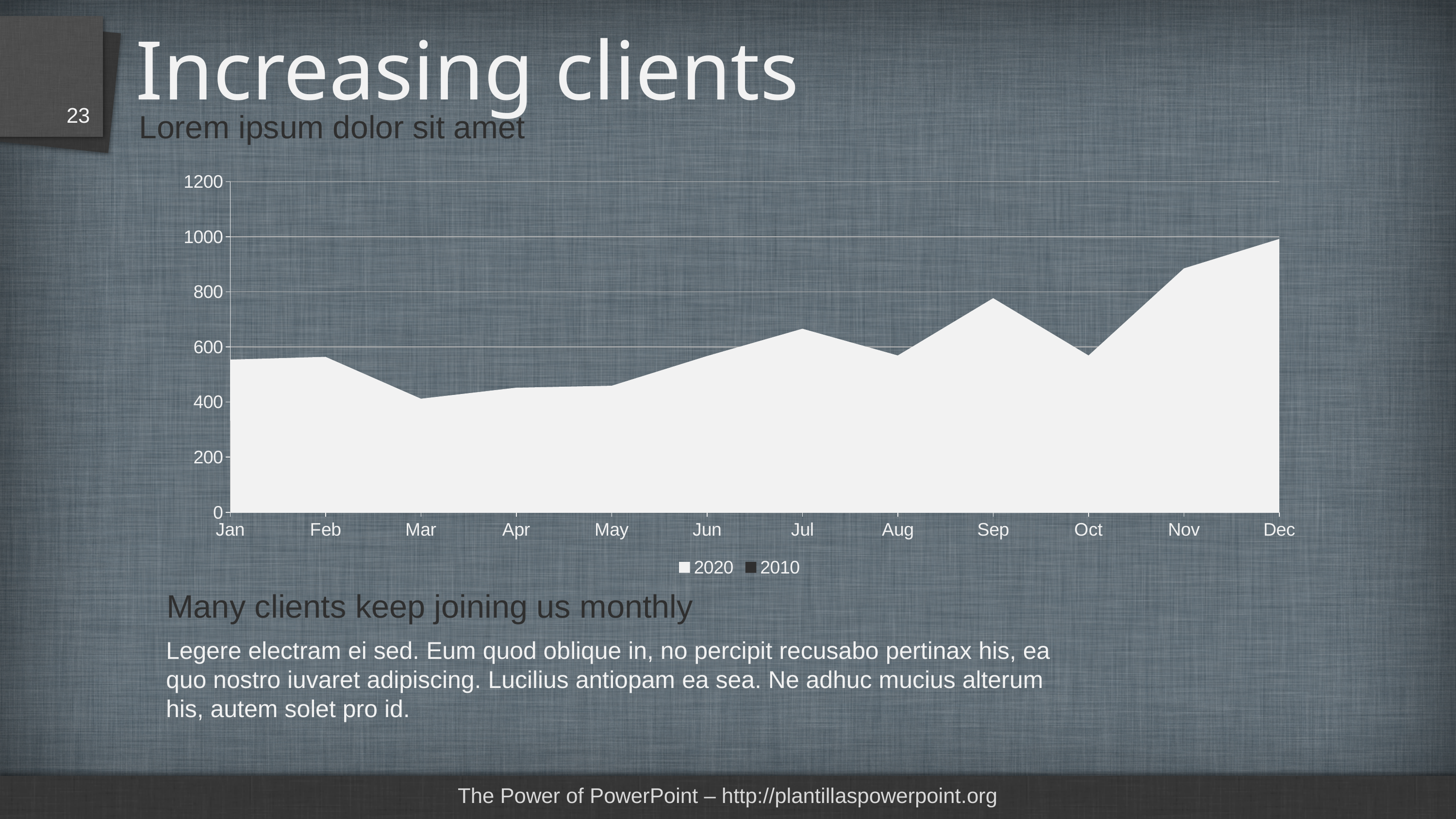
Which is larger in the 2020 series, the value for Dec or the value for Jan? Dec Overall, do the 2020 values rise or fall from Jan to Dec? rise Which month has the highest value for the 2020 series? Dec Is the value for Sep in the 2020 series greater or less than 600? greater Is the value for Nov in the 2020 series greater or less than 800? greater Is the value for Dec in the 2020 series greater or less than 800? greater What kind of chart is shown on the slide? area chart How many months are plotted along the x axis? 12 What are the two series named in the legend? 2020 and 2010 How many series does the legend list? 2 Which is larger in the 2020 series, the value for Sep or the value for Oct? Sep